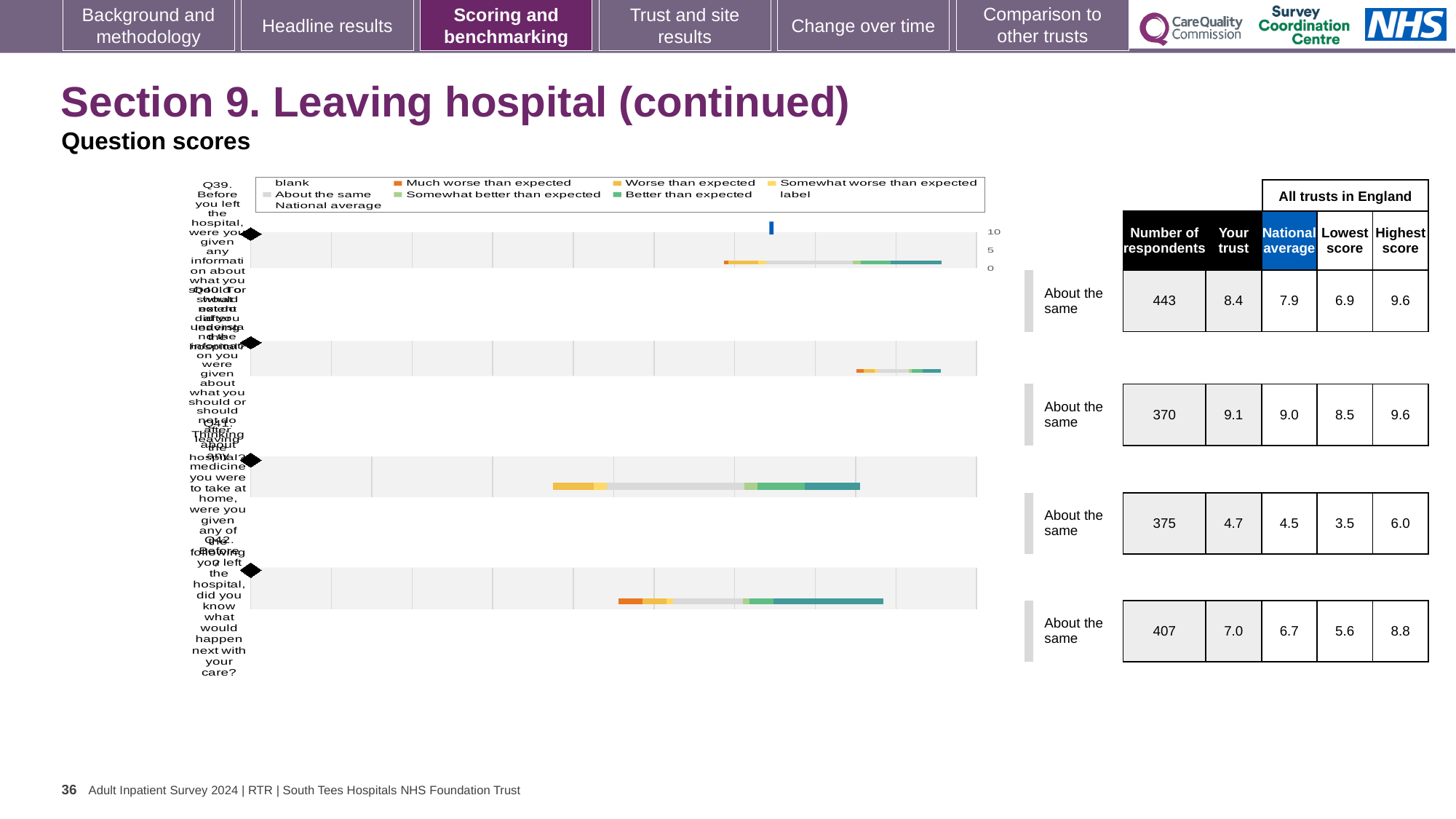
What is the number of respondents for Q42 (the last row of the chart)? 407 What is the 'Your trust' score for Q39 (the first row of the chart)? 8.4 Which row of the chart has the lowest 'Your trust' score? the third row (4.7) Which is larger for Q42 (the last row of the chart): the trust score or the national average? Your trust What colour does the legend use for 'Much worse than expected'? orange What benchmark category is shown for every question in the chart? About the same What is the 'Your trust' score for Q42 (the last row of the chart)? 7.0 What kind of chart is shown on the slide? bar chart What is the highest score among all trusts in England for Q42 (the last row of the chart)? 8.8 What is the difference between the trust score and the national average for Q39 (the first row of the chart)? 0.5 How many questions (rows) are plotted in the chart? 4 What is the national average for Q39 (the first row of the chart)? 7.9